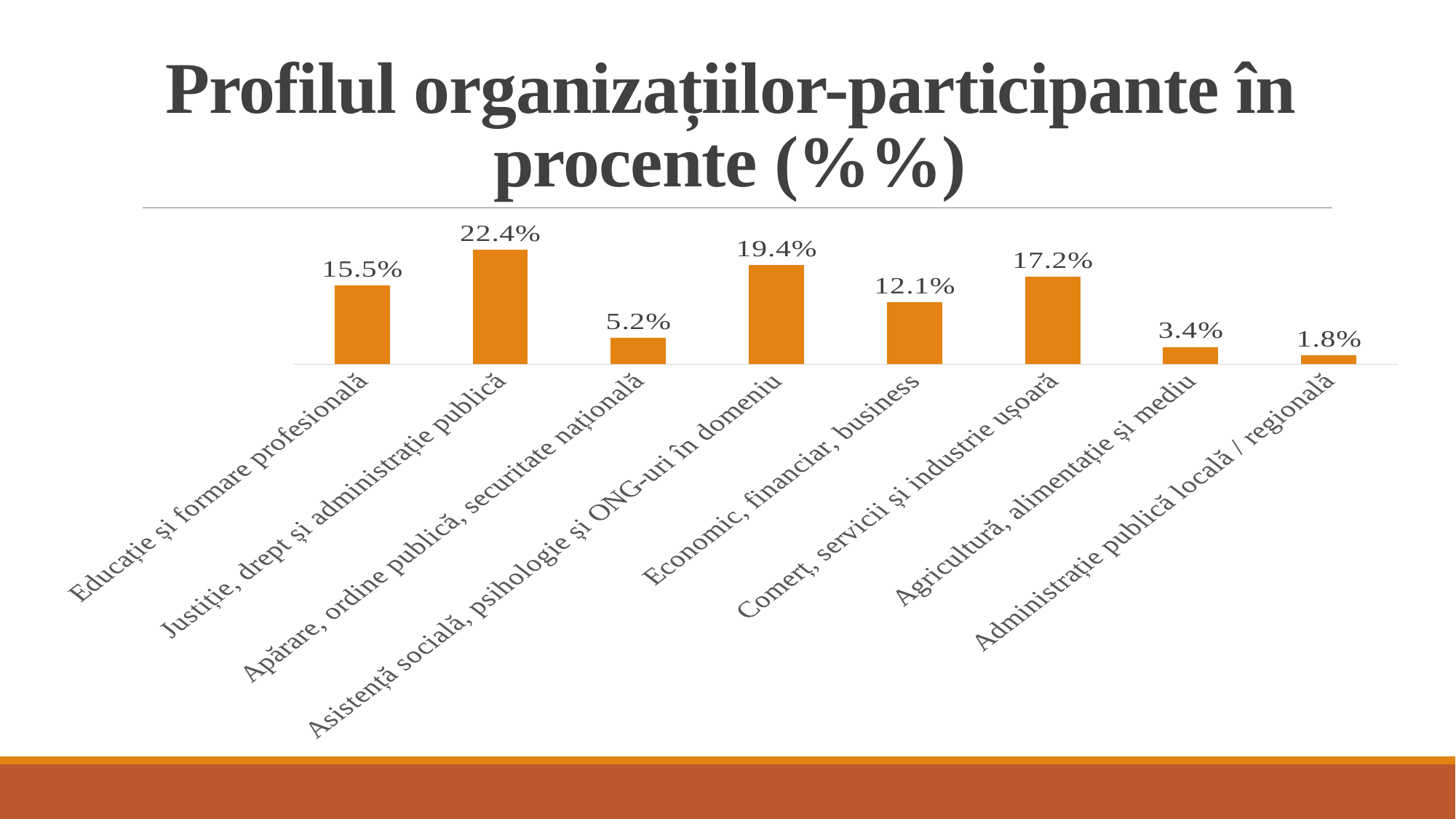
What is the value for Comerț, servicii și industrie ușoară? 17.2% Which is larger: Economic, financiar, business or Comerț, servicii și industrie ușoară? Comerț, servicii și industrie ușoară Which category has the highest value? Justiție, drept și administrație publică What kind of chart is shown on the slide? Bar chart What is the title of the chart on the slide? Profilul organizațiilor-participante în procente (%%) What is the difference between Justiție, drept și administrație publică and Asistență socială, psihologie și ONG-uri în domeniu? 3.0% Which category has the lowest value? Administrație publică locală / regională What is the value for Educație și formare profesională? 15.5% What is the value for Justiție, drept și administrație publică? 22.4% What is the value for Apărare, ordine publică, securitate națională? 5.2% How many categories are shown in the chart? 8 What is the value for Administrație publică locală / regională? 1.8%